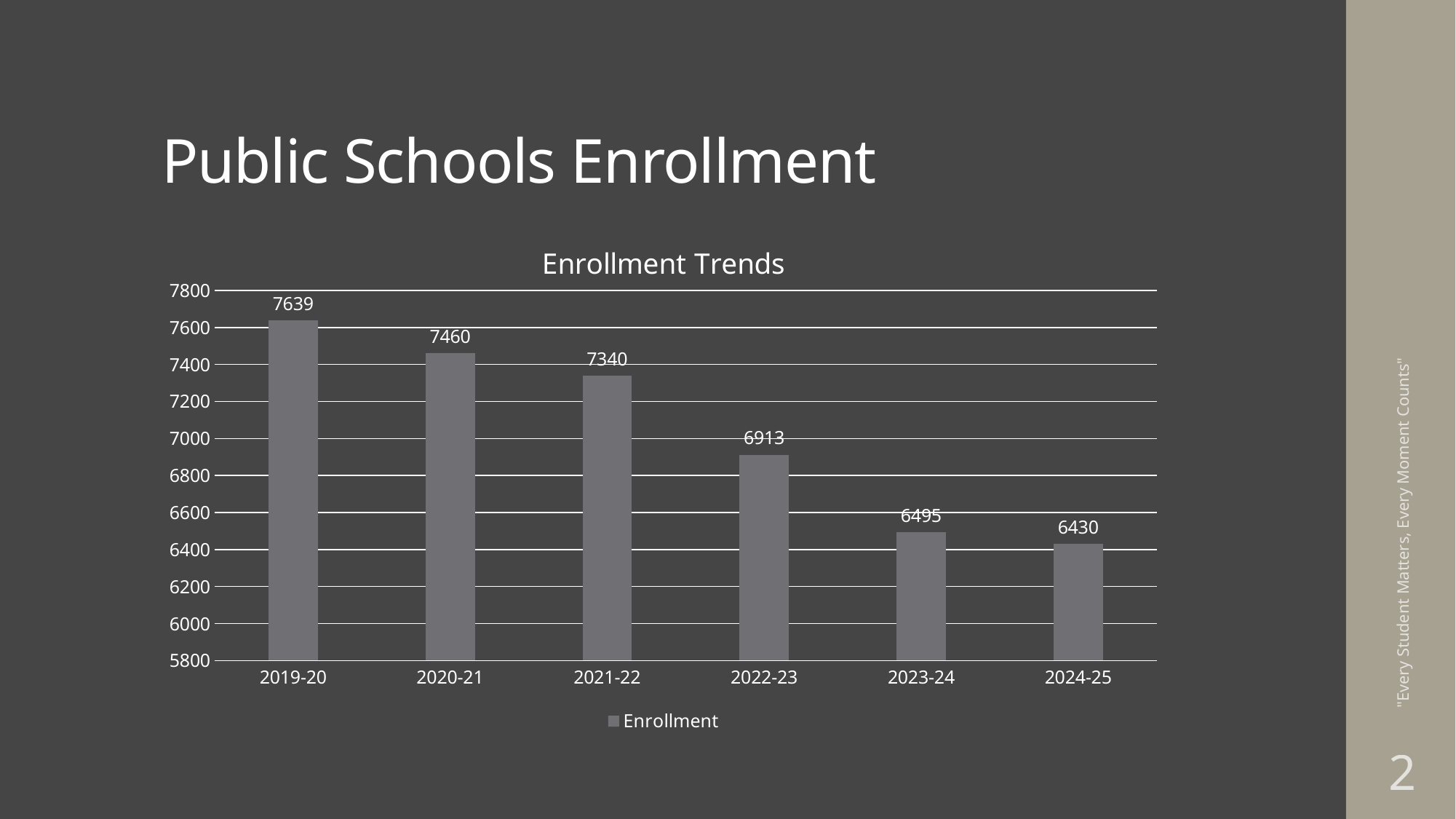
Which school year has the lowest enrollment? 2024-25 How many school years are shown on the chart? 6 What is the enrollment value for 2024-25? 6430 Which is larger, the enrollment for 2020-21 or for 2023-24? 2020-21 What is the difference in enrollment between 2021-22 and 2022-23? 427 Which school year has the highest enrollment? 2019-20 What is the enrollment value for 2019-20? 7639 How many series does the legend list? 1 What kind of chart is shown on the slide? Bar chart Do enrollment values rise or fall from 2019-20 to 2024-25? Fall What is the enrollment value for 2022-23? 6913 What is the difference in enrollment between 2019-20 and 2024-25? 1209